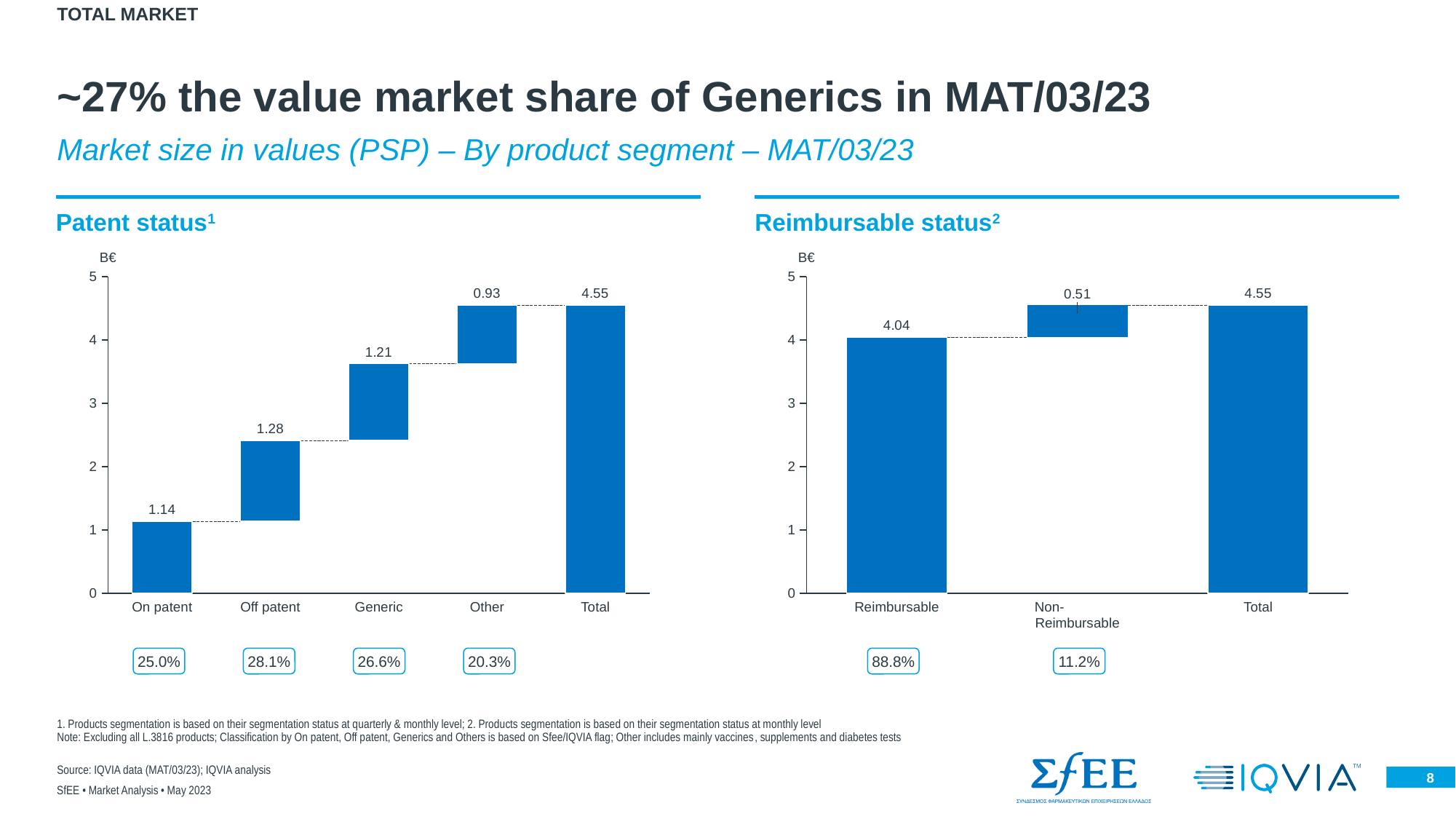
In the Patent status chart, what is the value for Off patent? 1.28 In the Reimbursable status chart, what is the value for Non-Reimbursable? 0.51 In the Reimbursable status chart, is the value for Non-Reimbursable greater or less than 1? less In the Reimbursable status chart, what is the difference between the Reimbursable and Non-Reimbursable values? 3.53 In the Patent status chart, which of the four product segments (excluding Total) has the lowest value? Other In the Patent status chart, what is the value for Generic? 1.21 In the Patent status chart, which of the four product segments (excluding Total) has the highest value? Off patent How many bars are shown in the Patent status chart? 5 In the Patent status chart, what is the difference between the Off patent and On patent values? 0.14 What kind of chart is the Reimbursable status chart? Bar chart In the Patent status chart, which is larger, the value for Generic or the value for Other? Generic In the Reimbursable status chart, what percentage share is shown for Reimbursable? 88.8%